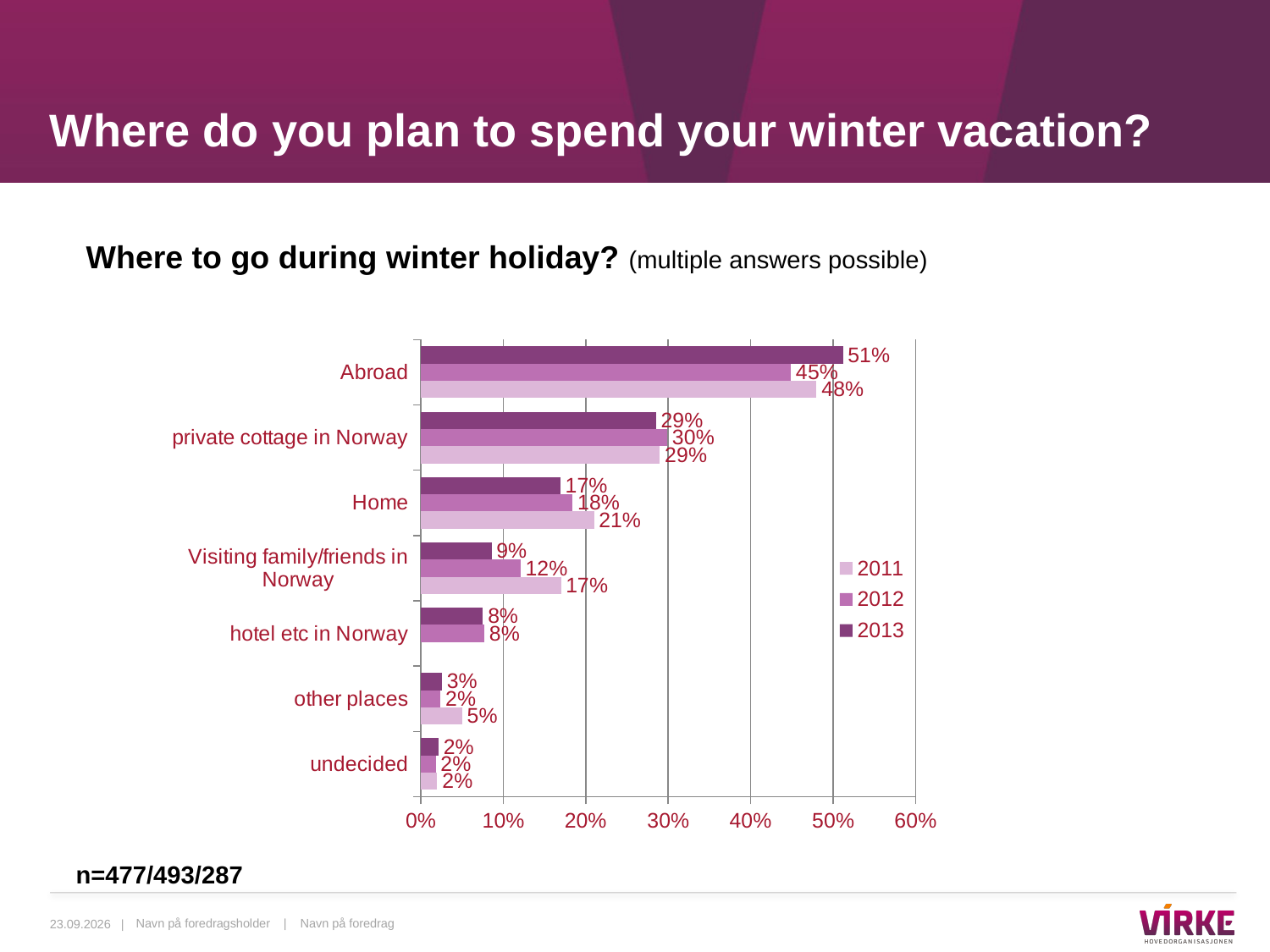
What is the difference between the 2013 and 2012 values for Abroad? 6% Which is larger for Visiting family/friends in Norway: the 2011 value or the 2013 value? 2011 Which category has the lowest value in 2011? undecided What is the value for Visiting family/friends in Norway in 2012? 12% Which category has the highest value in 2013? Abroad Is the 2012 value for private cottage in Norway greater or less than 20%? greater Which series is shown in the darkest colour in the legend? 2013 What is the value for Home in 2011? 21% How many series does the legend list? 3 How many categories are shown on the chart? 7 What kind of chart is shown on the slide? bar chart What is the value for Abroad in 2013? 51%